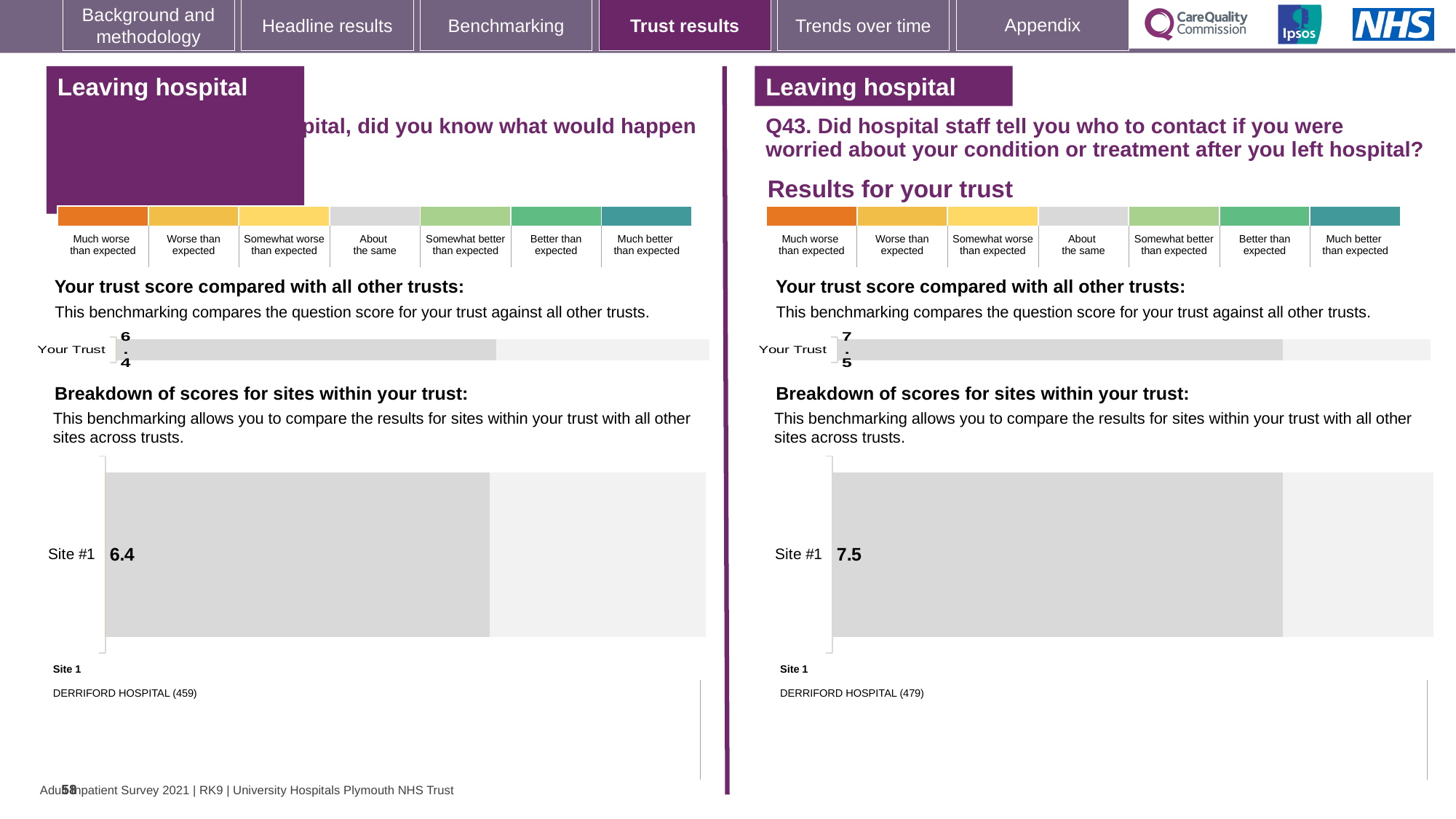
On the right-hand Q43 'Breakdown of scores for sites within your trust' chart, what is the score for Site #1? 7.5 On the right-hand Q43 'Your trust score compared with all other trusts' chart, what is the score for Your Trust? 7.5 On the left-hand 'Your trust score compared with all other trusts' chart, what is the score for Your Trust? 6.4 Which is larger: the Site #1 score on the left-hand breakdown chart or the Site #1 score on the right-hand Q43 breakdown chart? Right-hand Q43 chart (7.5) How many sites are shown in the right-hand Q43 'Breakdown of scores for sites within your trust' chart? 1 Which hospital is listed as Site 1 beneath the right-hand Q43 breakdown chart? DERRIFORD HOSPITAL Is the Your Trust score on the left-hand chart greater or less than 7? less On the left-hand 'Breakdown of scores for sites within your trust' chart, what is the score for Site #1? 6.4 What is the difference between the Your Trust score on the right-hand Q43 chart and the Your Trust score on the left-hand chart? 1.1 Is the Site #1 score on the right-hand Q43 breakdown chart greater or less than 7? greater What kind of chart is used for the 'Breakdown of scores for sites within your trust' on the right-hand side? Bar chart How many bars are plotted in the left-hand 'Your trust score compared with all other trusts' chart? 1